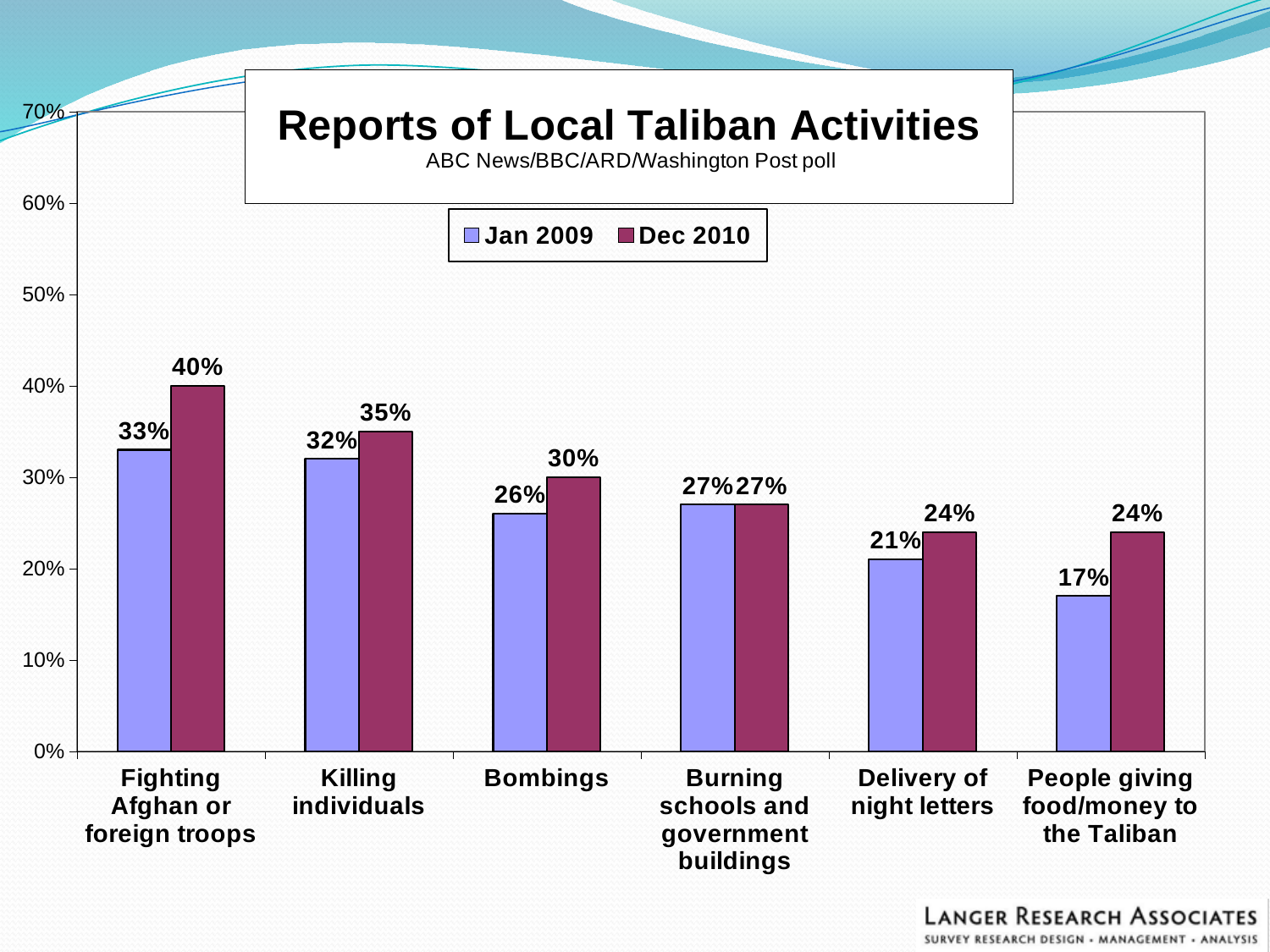
What is the difference between the Dec 2010 and Jan 2009 values for People giving food/money to the Taliban? 7% What kind of chart is shown on the slide? Bar chart How many categories are shown on the x axis? 6 What is the Jan 2009 value for People giving food/money to the Taliban? 17% What is the title of the chart? Reports of Local Taliban Activities Which category has the lowest Jan 2009 value? People giving food/money to the Taliban Which category has the highest Dec 2010 value? Fighting Afghan or foreign troops Is the Dec 2010 value for Bombings greater or less than 20%? greater What is the Dec 2010 value for Fighting Afghan or foreign troops? 40% What is the Jan 2009 value for Bombings? 26% Which is larger for Killing individuals: the Jan 2009 value or the Dec 2010 value? Dec 2010 How many series does the legend list? 2